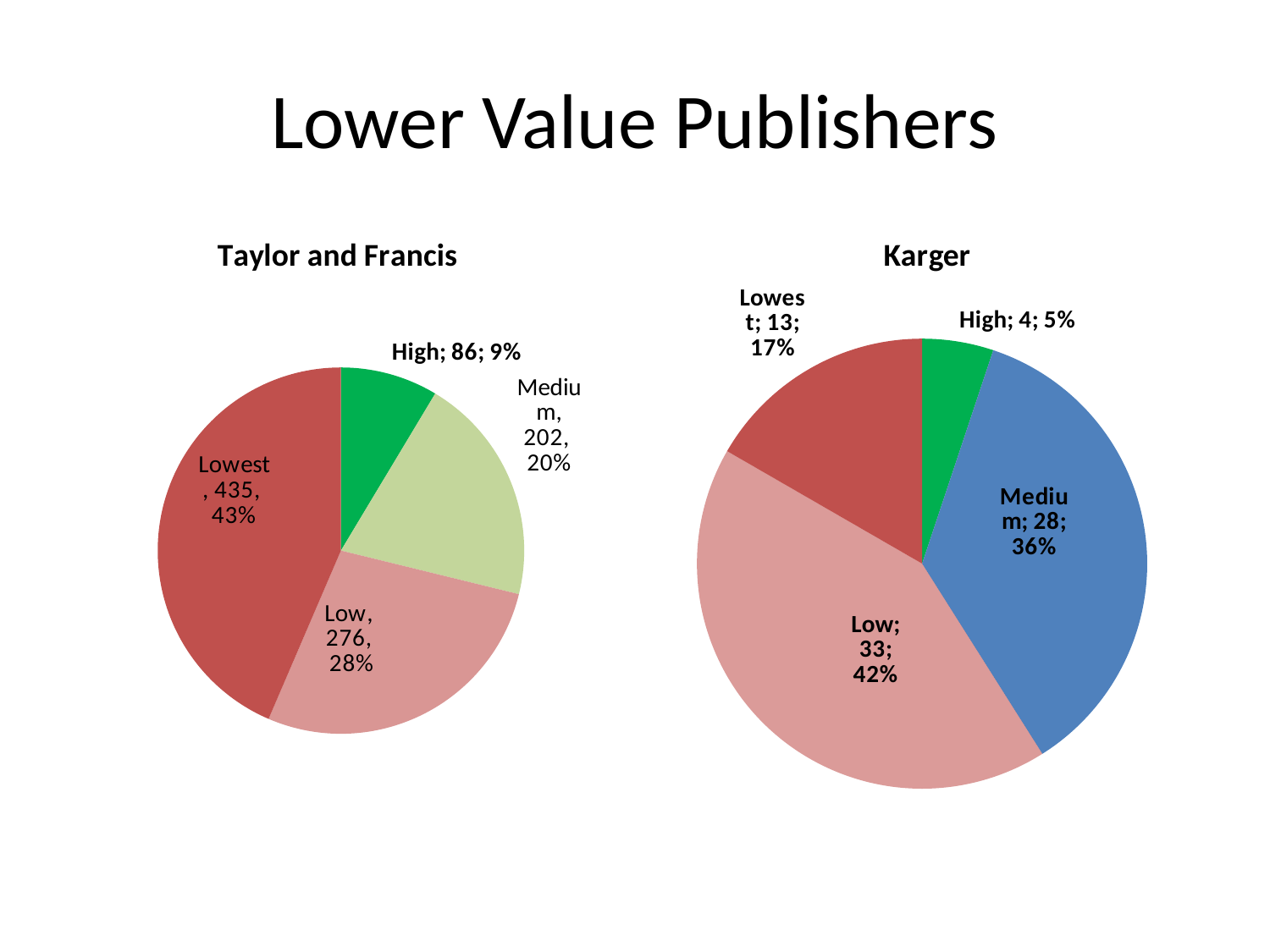
In the Karger chart, which category has the smallest slice? High In the Karger chart, what share of the pie does Low have? 42% In the Karger chart, what is the value for Medium? 28 What kind of chart is the Taylor and Francis chart? Pie chart In the Taylor and Francis chart, what share of the pie does Medium have? 20% In the Taylor and Francis chart, what is the value for Lowest? 435 In the Taylor and Francis chart, which category has the smallest slice? High In the Karger chart, which category has the largest slice? Low In the Taylor and Francis chart, which category has the largest slice? Lowest How many categories does the Karger chart show? 4 In the Karger chart, which is larger, the value for Lowest or the value for High? Lowest In the Taylor and Francis chart, what is the difference between the Low and Medium values? 74